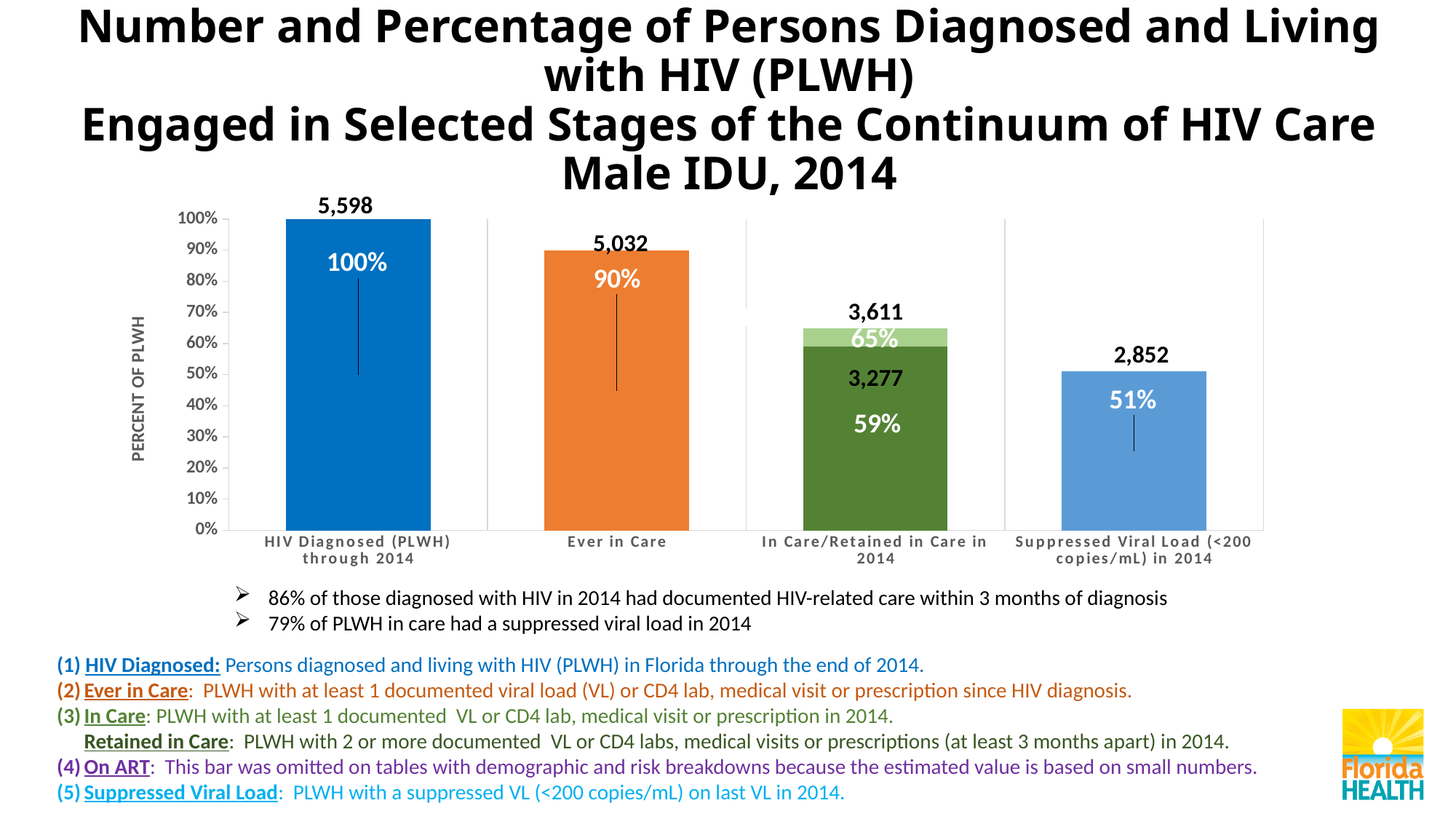
What type of chart is shown on the slide? Bar chart What is the difference in number of persons between HIV Diagnosed (PLWH) through 2014 and Ever in Care? 566 What number is shown for HIV Diagnosed (PLWH) through 2014? 5,598 What number is shown for Suppressed Viral Load (<200 copies/mL) in 2014? 2,852 Which category has the lowest percentage of PLWH? Suppressed Viral Load (<200 copies/mL) in 2014 Which category has the highest number of persons? HIV Diagnosed (PLWH) through 2014 How many categories are shown on the x axis of the chart? 4 Which is larger, the number for Ever in Care or the number for Suppressed Viral Load (<200 copies/mL) in 2014? Ever in Care What percentage of PLWH is shown for Ever in Care? 90% What percentage is shown for Retained in Care (the darker green portion of the In Care/Retained in Care bar)? 59% What is the difference in percentage points between In Care (65%) and Retained in Care (59%)? 6 What number is shown for In Care in 2014 (the top of the In Care/Retained in Care bar)? 3,611